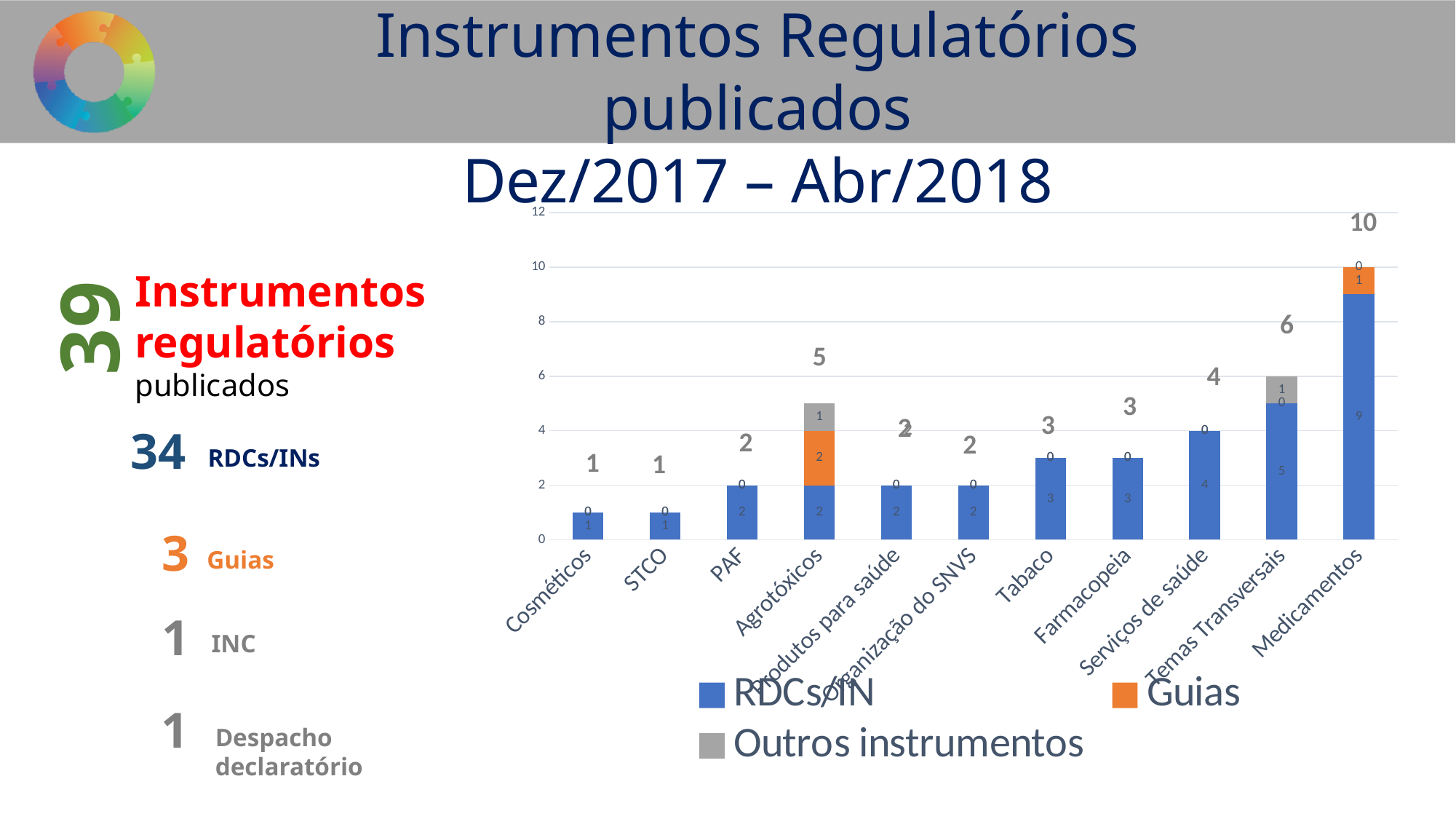
What is the difference between the total for Medicamentos and the total for Temas Transversais? 4 What is the RDCs/IN value for Tabaco? 3 What is the Outros instrumentos value for Temas Transversais? 1 What is the RDCs/IN value for Medicamentos? 9 What kind of chart is shown on the slide? stacked bar chart What is the Guias value for Agrotóxicos? 2 Which is larger, the total for Agrotóxicos or the total for Serviços de saúde? Agrotóxicos How many categories are shown on the x axis of the chart? 11 What is the total value of the bar for Medicamentos? 10 Which legend entry is shown in orange? Guias Which category has the highest total bar? Medicamentos How many series does the chart legend list? 3